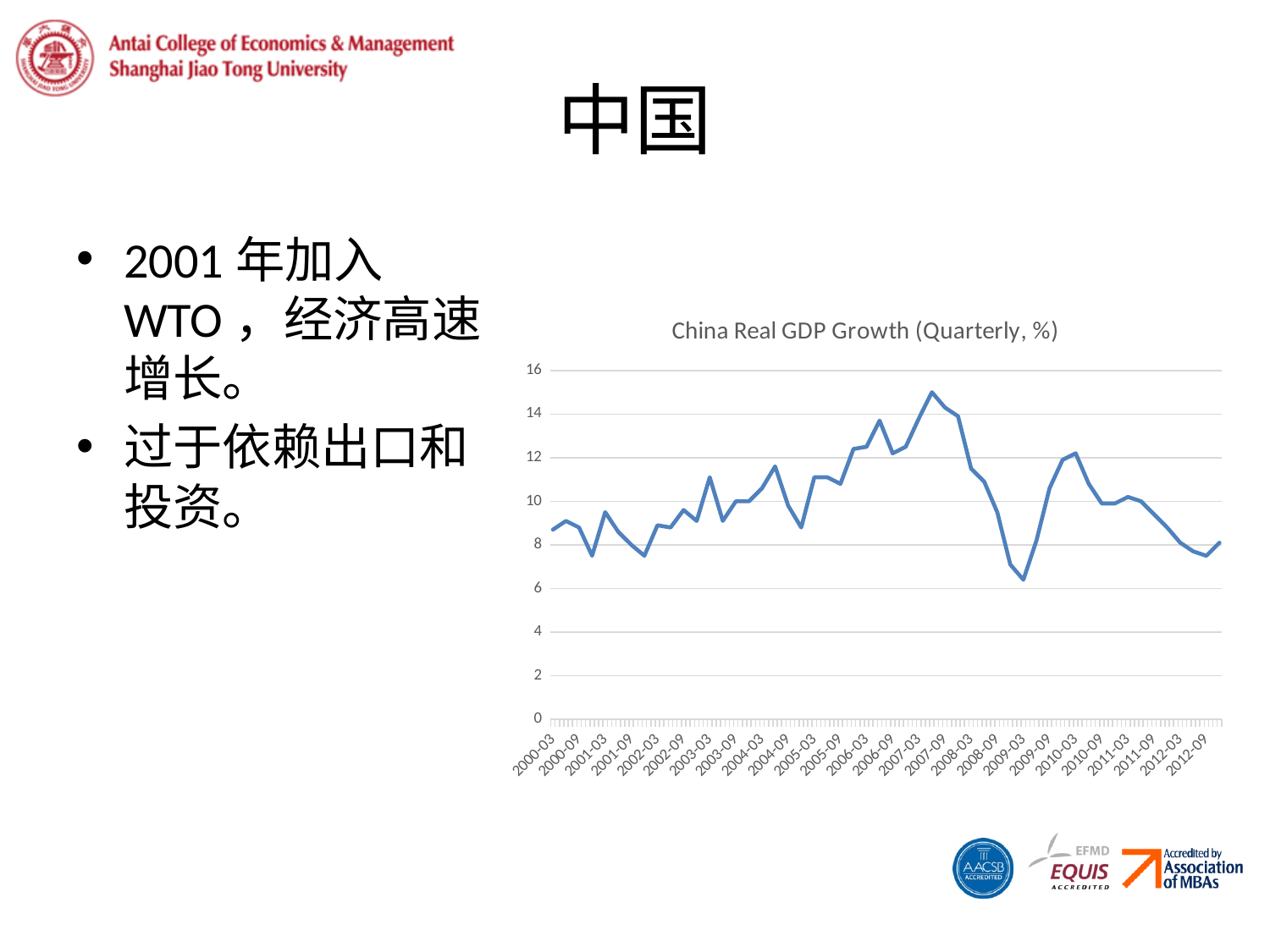
Do the values rise or fall between 2007-09 and 2009-03? fall Is the value for 2010-03 greater or less than 10? greater Is the peak value of the line in 2007 greater or less than 14? greater Do the values rise or fall between 2009-03 and 2010-03? rise Is the value for 2009-03 greater or less than 8? less In which year does the line reach its highest value? 2007 In which year does the line reach its lowest value? 2009 What is the title of the chart? China Real GDP Growth (Quarterly, %) What kind of chart is shown on the slide? line chart What is the highest value shown on the chart's vertical axis? 16